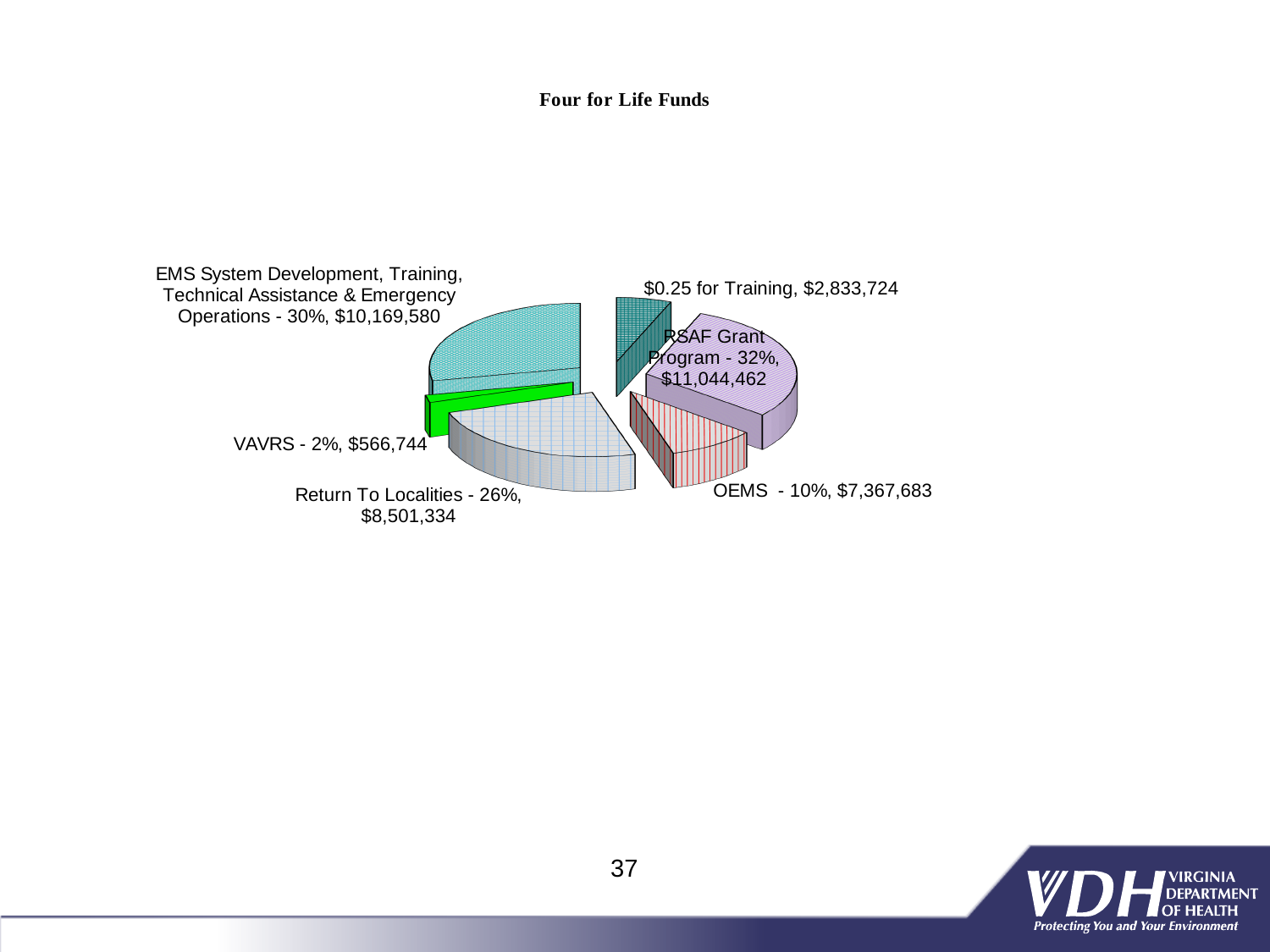
Which category has the smallest percentage share? VAVRS What dollar amount is shown for $0.25 for Training? $2,833,724 How many slices does the pie chart have? 6 What percentage share is shown for VAVRS? 2% What is the title of the chart? Four for Life Funds What dollar amount is shown for OEMS? $7,367,683 What kind of chart is shown on the slide? Pie chart What percentage share is shown for EMS System Development, Training, Technical Assistance & Emergency Operations? 30% What dollar amount is shown for Return To Localities? $8,501,334 Which category has the largest percentage share? RSAF Grant Program What dollar amount is shown for the RSAF Grant Program? $11,044,462 What is the difference in dollars between the RSAF Grant Program and Return To Localities? $2,543,128